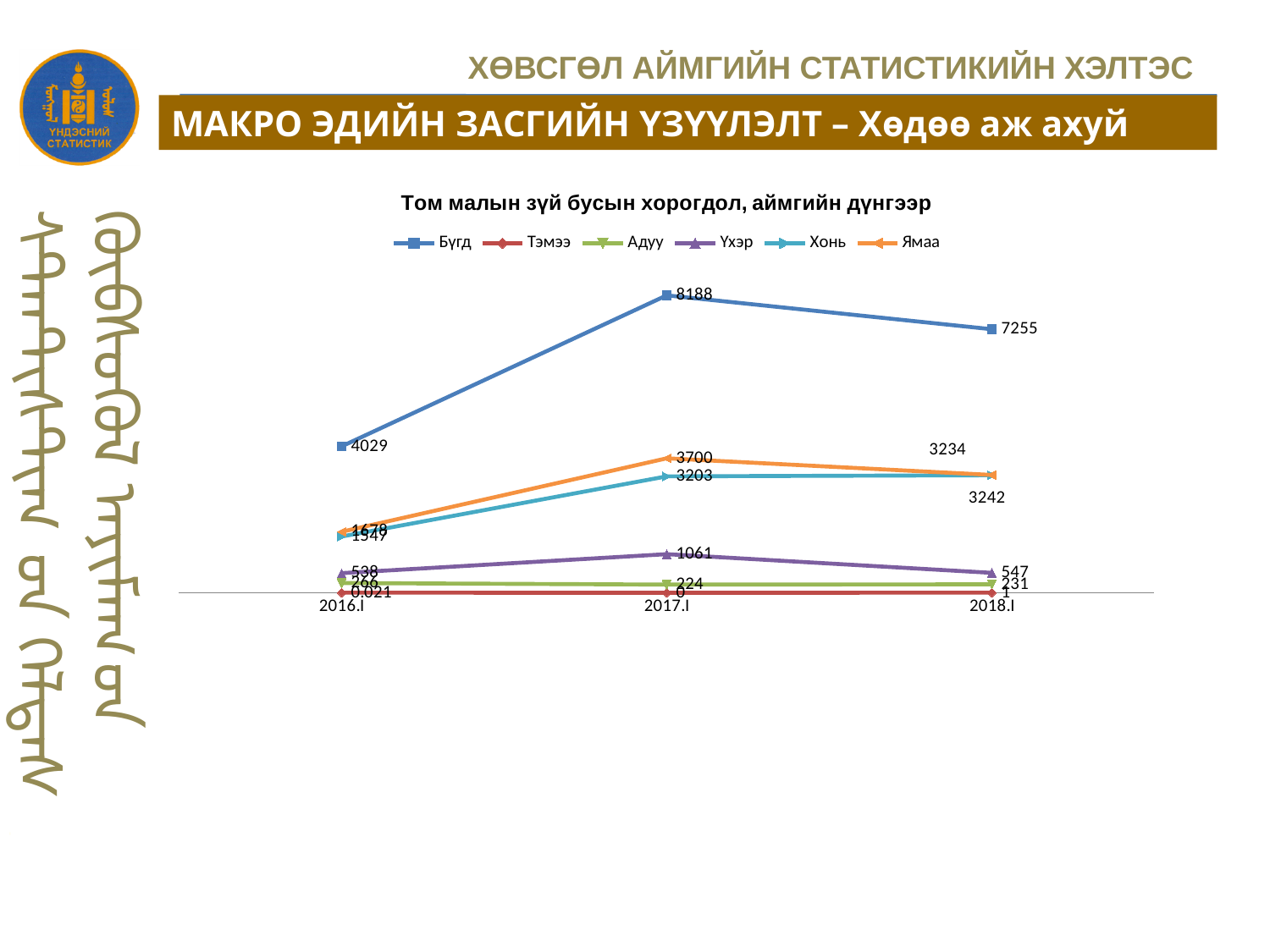
What is the difference between the Бүгд values at 2017.I and 2018.I? 933 What is the value of Бүгд at 2017.I? 8188 Does the Бүгд series rise or fall from 2016.I to 2017.I? rise How many series does the legend list? 6 What kind of chart is shown on the slide? line chart Which is larger at 2017.I, Үхэр or Адуу? Үхэр How many time points are shown on the x axis? 3 What is the value of Адуу at 2018.I? 231 What is the value of Бүгд at 2018.I? 7255 What is the value of Бүгд at 2016.I? 4029 What is the value of Үхэр at 2017.I? 1061 In which period is the Бүгд series highest? 2017.I